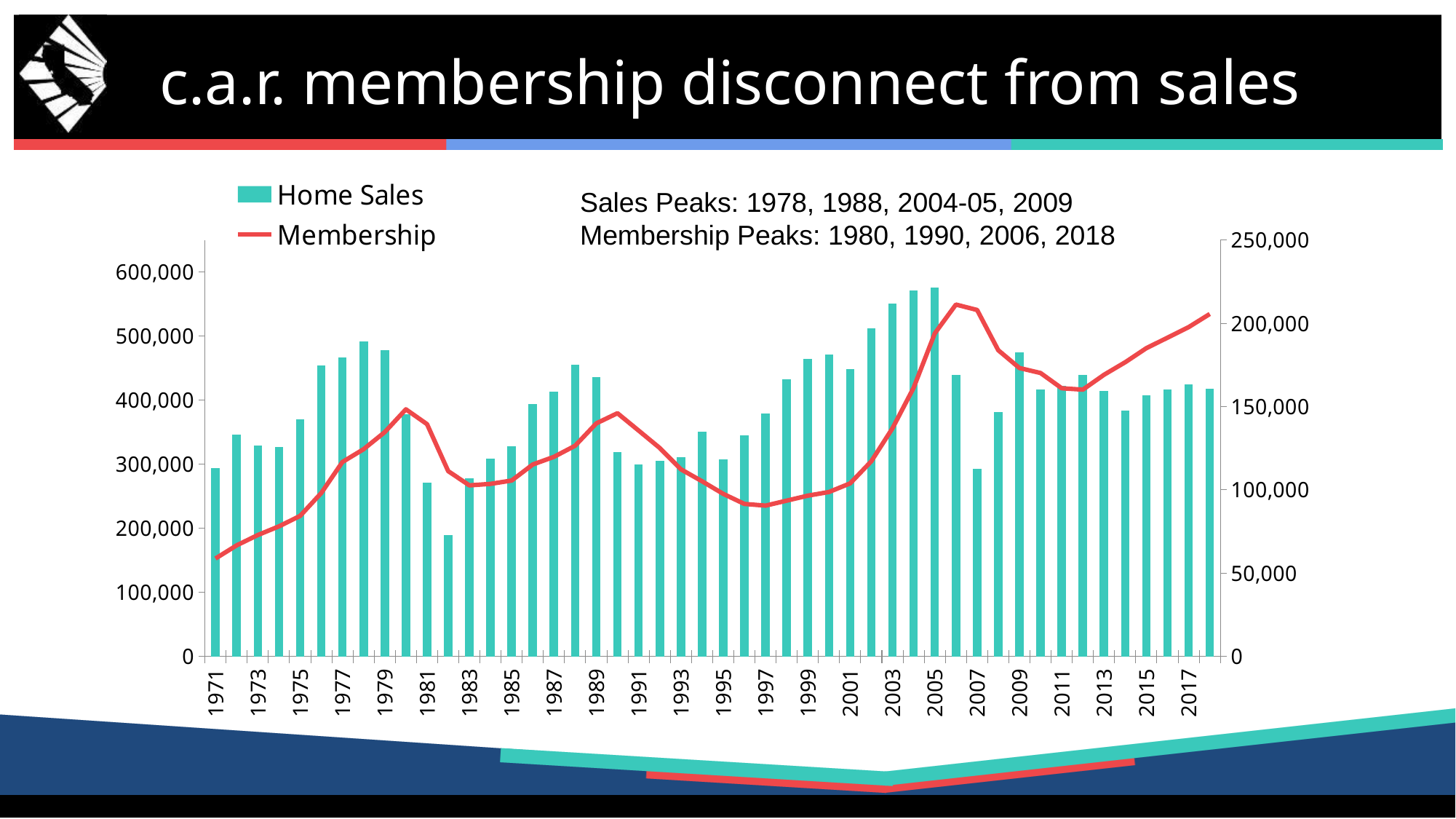
How many series does the legend list? 2 What kind of chart is shown on the slide? A combined bar and line chart What is the title of the slide? c.a.r. membership disconnect from sales In which year is the Home Sales bar the lowest? 1982 Is the Membership value for 2006 greater or less than 200,000? greater Which year has the larger Home Sales value, 2005 or 2007? 2005 Does the Membership line rise or fall between 2012 and 2018? rise In which year is the Home Sales bar the highest? 2005 Is the Membership value for 1971 greater or less than 100,000? less Is the Home Sales value for 2005 greater or less than 500,000? greater Which series is drawn as a red line? Membership